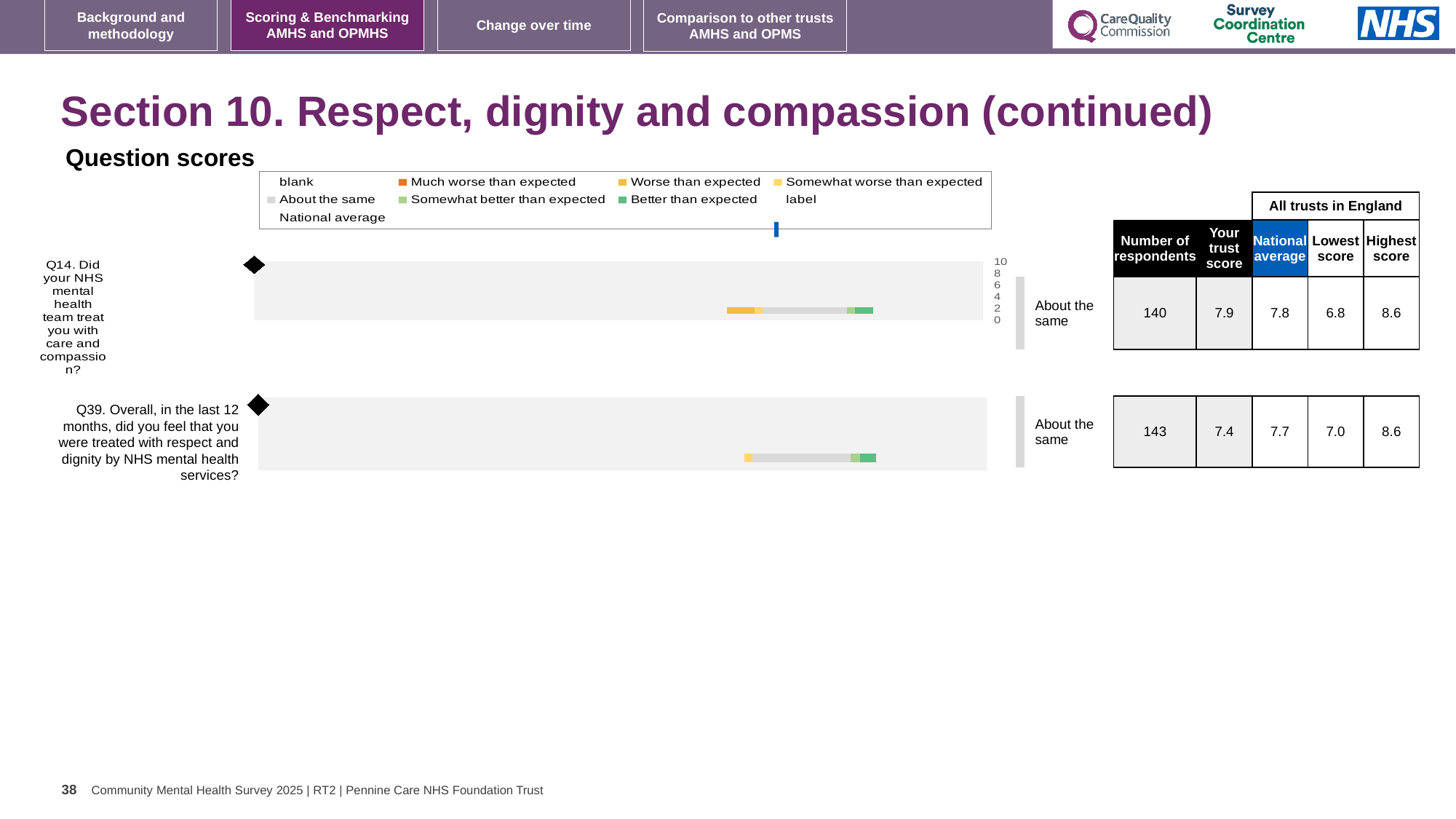
What is the national average score for Q14? 7.8 For Q39, what is the difference between the highest score and the lowest score among all trusts in England? 1.6 What is the trust score for Q39 (respect and dignity)? 7.4 Which question has the higher trust score, Q14 or Q39? Q14 How many respondents answered Q39? 143 What benchmark category is shown for Q39? About the same For Q14, which is larger: the trust score or the national average? the trust score How many questions are plotted in the question scores charts? 2 What is the highest value shown on the score axis of the charts? 10 What is the lowest score among all trusts in England for Q14? 6.8 What is the trust score for Q14 (care and compassion)? 7.9 What kind of chart is used to show the question scores for Q14 and Q39? bar chart